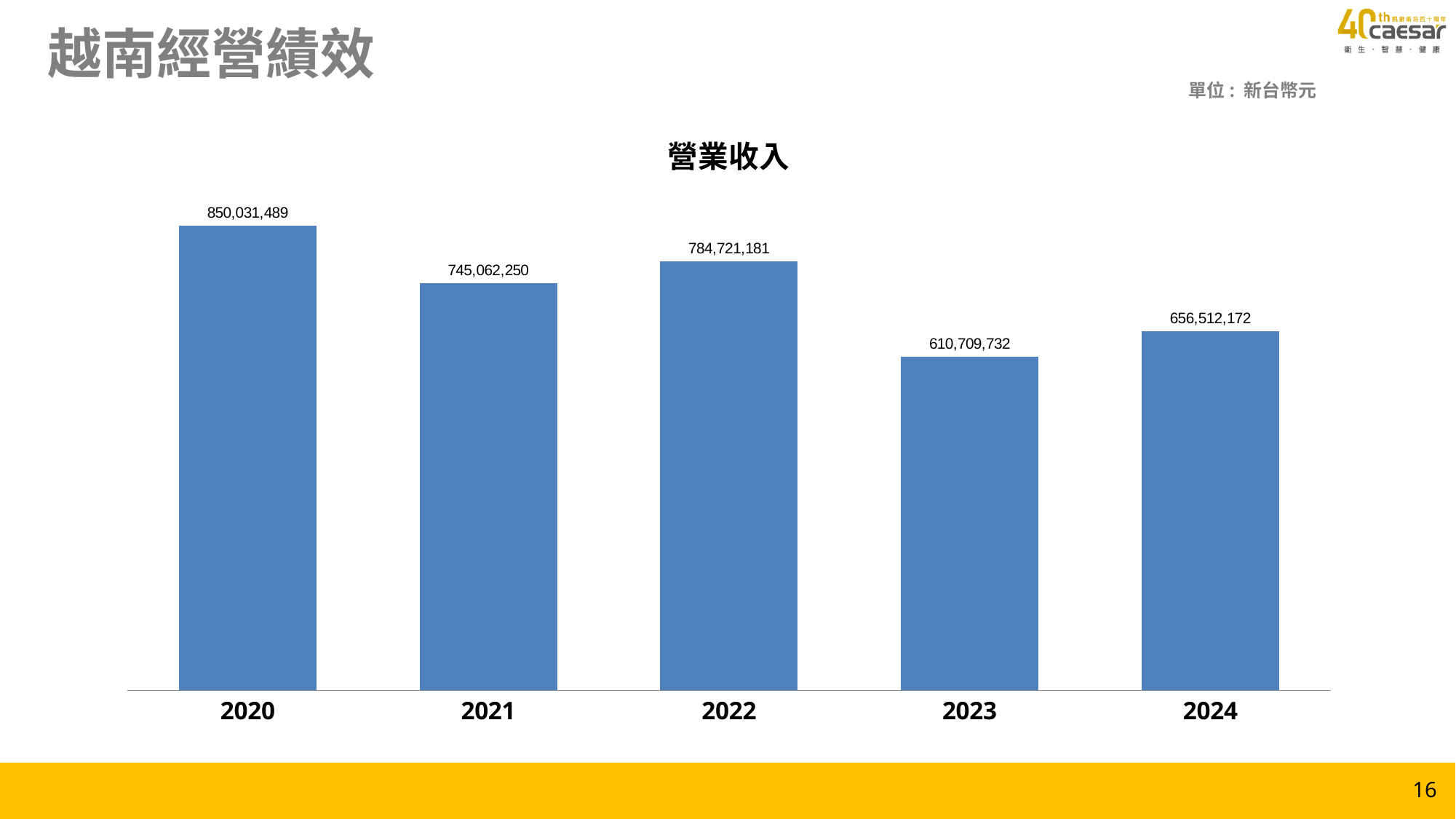
How many years are shown in the chart? 5 What kind of chart is shown on the slide? Bar chart What is the difference between the operating revenue in 2020 and in 2021? 104,969,239 What unit is stated for the values on the slide? 新台幣元 By how much did operating revenue increase from 2023 to 2024? 45,802,440 What is the operating revenue (營業收入) for 2020? 850,031,489 Which year has higher operating revenue, 2021 or 2022? 2022 Does operating revenue rise or fall from 2022 to 2023? Fall What is the operating revenue (營業收入) for 2024? 656,512,172 Which year has the highest operating revenue? 2020 Which year has the lowest operating revenue? 2023 What is the operating revenue (營業收入) for 2023? 610,709,732